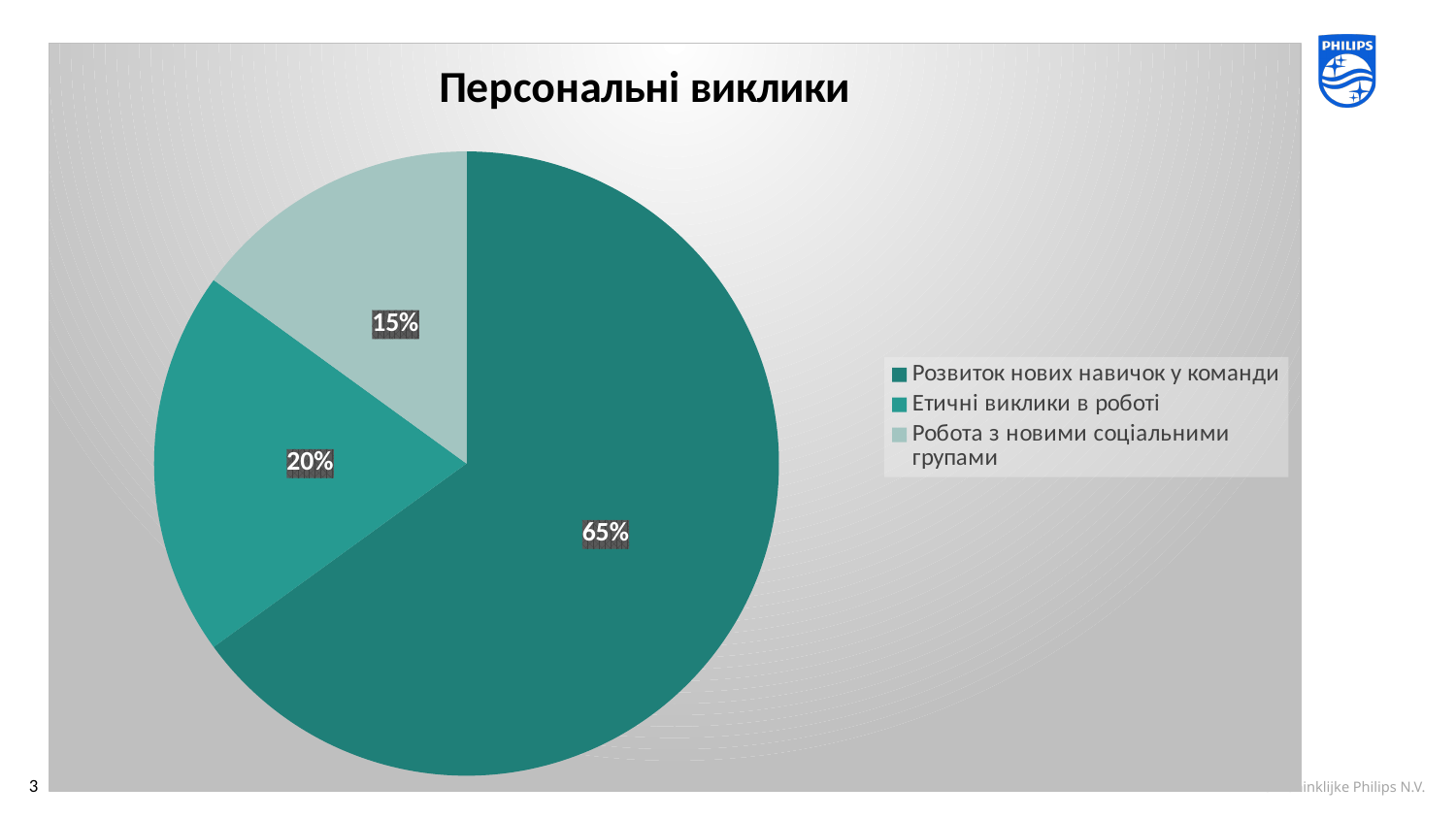
What share of the pie does 'Розвиток нових навичок у команди' take? 65% Which is larger: the slice for 'Етичні виклики в роботі' or the slice for 'Робота з новими соціальними групами'? Етичні виклики в роботі Which category has the largest slice of the pie? Розвиток нових навичок у команди What is the difference in percentage points between 'Етичні виклики в роботі' and 'Робота з новими соціальними групами'? 5 What is the title of the chart? Персональні виклики What share of the pie does 'Етичні виклики в роботі' take? 20% How many entries does the legend list? 3 What is the difference in percentage points between 'Розвиток нових навичок у команди' and 'Етичні виклики в роботі'? 45 What type of chart is shown on the slide? Pie chart What share of the pie does 'Робота з новими соціальними групами' take? 15% Which category has the smallest slice of the pie? Робота з новими соціальними групами How many categories are shown in the pie chart? 3